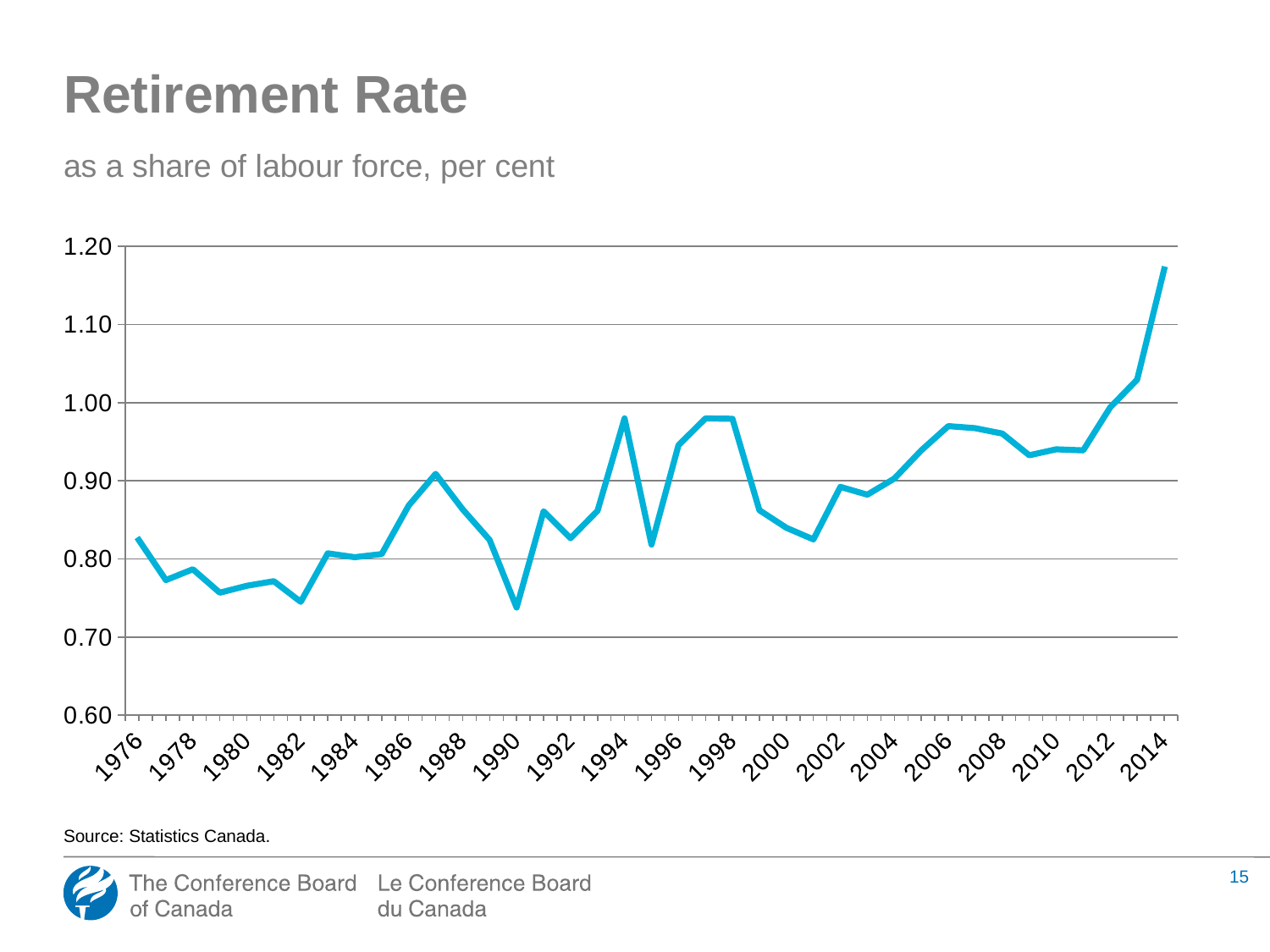
Is the value for 2014 greater or less than 1.10? greater In which year does the retirement rate reach its highest value? 2014 Which year has the larger retirement rate, 1976 or 2014? 2014 What is the title of the chart on the slide? Retirement Rate Overall, does the retirement rate rise or fall between 1976 and 2014? rise What kind of chart is shown on the slide? line chart Is the value for 2000 greater or less than 0.90? less Is the value for 2006 greater or less than 0.90? greater According to the subtitle, in what units is the retirement rate expressed? as a share of labour force, per cent